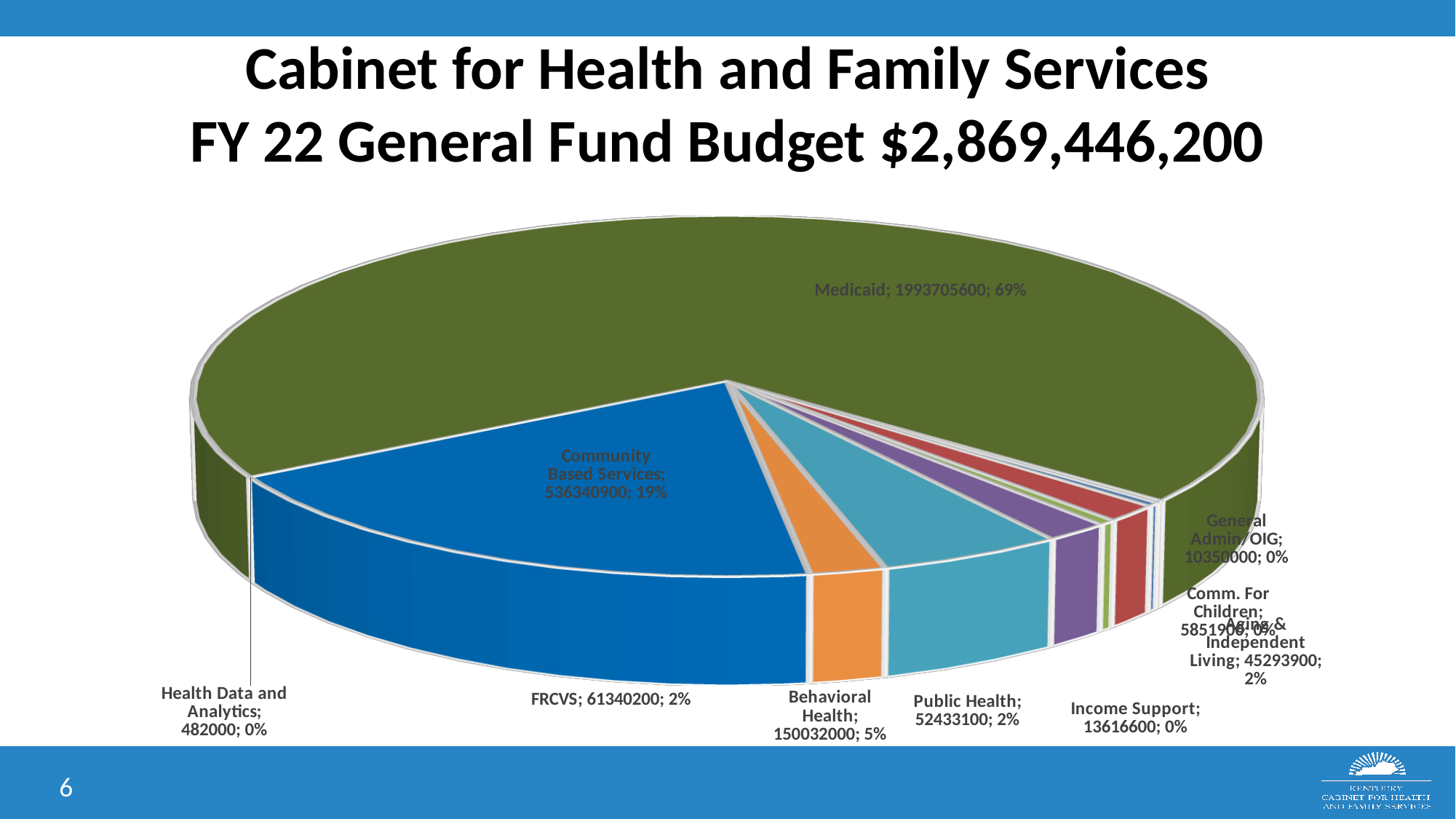
Which category has the largest slice of the pie? Medicaid What is the value for Income Support? 13616600 What share of the pie does Medicaid represent? 69% What kind of chart is shown on the slide? pie chart What is the value for Medicaid? 1993705600 What is the value for Community Based Services? 536340900 What is the difference between the values for Public Health and Aging & Independent Living? 7139200 What total budget amount is stated in the slide title? $2,869,446,200 Which category has the smallest value? Health Data and Analytics What share of the pie does Behavioral Health represent? 5% Which is larger, Behavioral Health or Public Health? Behavioral Health How many categories are shown in the pie chart? 10